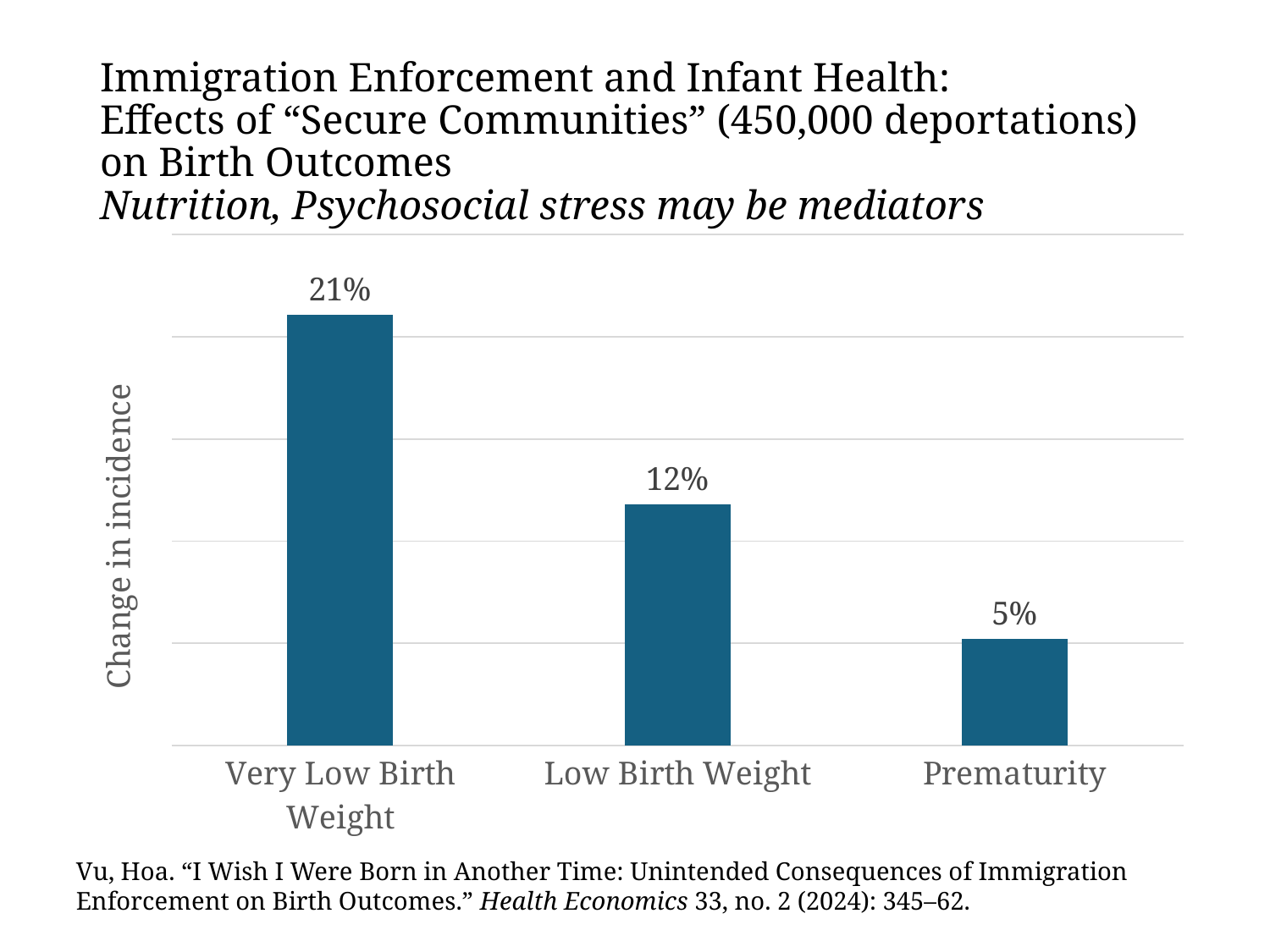
What kind of chart is shown on the slide? Bar chart Which is larger, the change in incidence for Low Birth Weight or for Prematurity? Low Birth Weight Which category has the highest change in incidence? Very Low Birth Weight What is the label on the vertical axis of the chart? Change in incidence How many categories are shown on the chart? 3 What is the change in incidence for Low Birth Weight? 12% What is the change in incidence for Prematurity? 5% What is the difference between the change in incidence for Very Low Birth Weight and Low Birth Weight? 9% What is the change in incidence for Very Low Birth Weight? 21% Which category has the lowest change in incidence? Prematurity Do the values rise or fall from left to right across the categories? Fall What is the difference between the change in incidence for Low Birth Weight and Prematurity? 7%